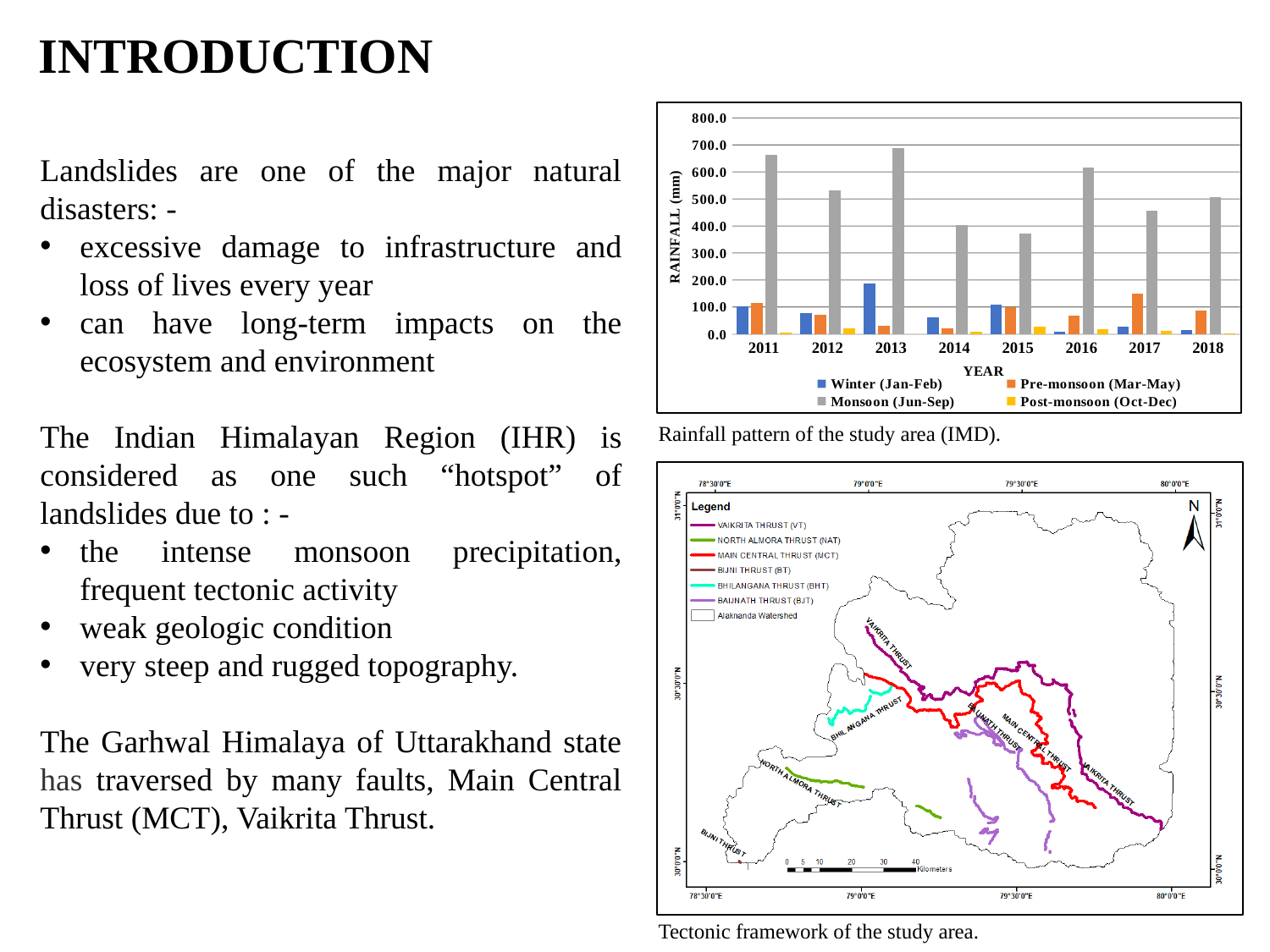
In the rainfall chart, which year has the lowest Monsoon (Jun-Sep) rainfall? 2015 In the rainfall chart, is the Monsoon (Jun-Sep) value for 2014 greater or less than 500? less In the rainfall chart, which year has the highest Winter (Jan-Feb) rainfall? 2013 In the rainfall chart, is the Monsoon (Jun-Sep) value for 2013 greater or less than 600? greater How many years are shown on the x axis of the rainfall chart? 8 In the rainfall chart, is the Winter (Jan-Feb) value for 2013 greater or less than 100? greater In the rainfall chart, which year has the highest Monsoon (Jun-Sep) rainfall? 2013 What is the label of the y axis of the rainfall chart? RAINFALL (mm) In the rainfall chart, which year has the highest Pre-monsoon (Mar-May) rainfall? 2017 In the rainfall chart, which year has the larger Monsoon (Jun-Sep) rainfall, 2016 or 2017? 2016 How many series does the legend of the rainfall chart list? 4 What kind of chart is the rainfall chart on the slide? bar chart